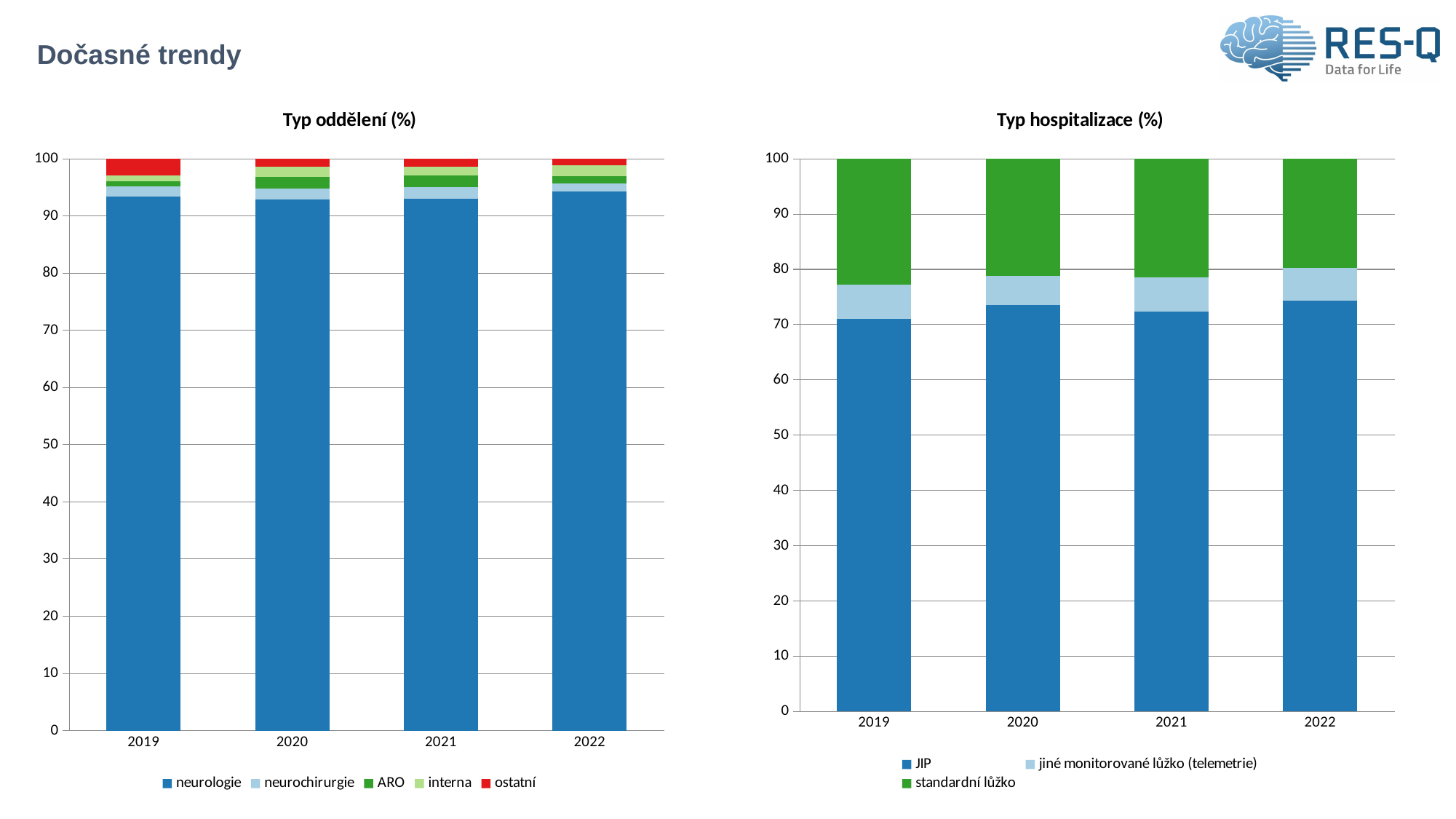
In the "Typ oddělení (%)" chart, which year has the largest ostatní segment? 2019 In the "Typ hospitalizace (%)" chart, is the JIP value larger in 2019 or in 2022? 2022 How many series does the legend of the "Typ oddělení (%)" chart list? 5 In the "Typ hospitalizace (%)" chart, what is the total height of the stacked bar for 2019? 100 How many series does the legend of the "Typ hospitalizace (%)" chart list? 3 In the "Typ hospitalizace (%)" chart, is the JIP value for 2022 greater or less than 80? less In the "Typ hospitalizace (%)" chart, is the JIP value for 2019 greater or less than 70? greater What kind of chart is the "Typ oddělení (%)" chart on the left? Stacked bar chart Which series in the "Typ oddělení (%)" chart is shown in red? ostatní In the "Typ oddělení (%)" chart, is the neurologie value for 2019 greater or less than 90? greater How many years are shown on the x axis of the "Typ hospitalizace (%)" chart? 4 In the "Typ hospitalizace (%)" chart, which year has the lowest JIP value? 2019